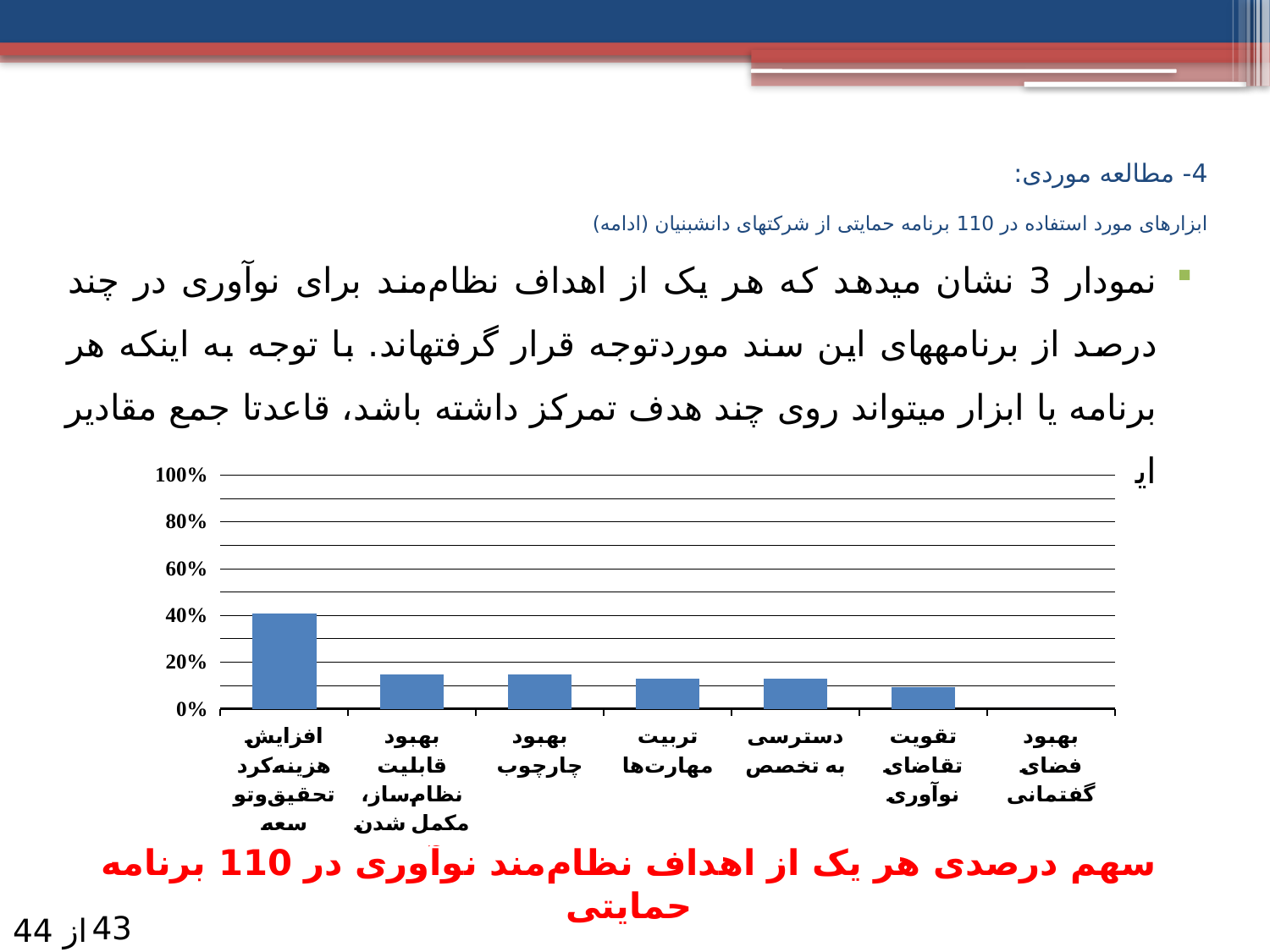
How many categories are plotted on the x axis of the chart? 7 Which category has the highest value in the chart? افزایش هزینه‌کرد تحقیق‌وتوسعه Is the value for افزایش هزینه‌کرد تحقیق‌وتوسعه greater or less than 20%? greater Do the bar values generally rise or fall moving from left to right along the x axis? fall What kind of chart is shown on the slide? bar chart Is the value for بهبود چارچوب greater or less than 40%? less What is the title shown below the chart? سهم درصدی هر یک از اهداف نظام‌مند نوآوری در 110 برنامه حمایتی Which is larger, the value for افزایش هزینه‌کرد تحقیق‌وتوسعه or the value for تربیت مهارت‌ها? افزایش هزینه‌کرد تحقیق‌وتوسعه Which is larger, the value for بهبود چارچوب or the value for تقویت تقاضای نوآوری? بهبود چارچوب Is the value for تقویت تقاضای نوآوری greater or less than 20%? less Which category has the lowest value in the chart? بهبود فضای گفتمانی What is the highest value shown on the chart's y axis? 100%